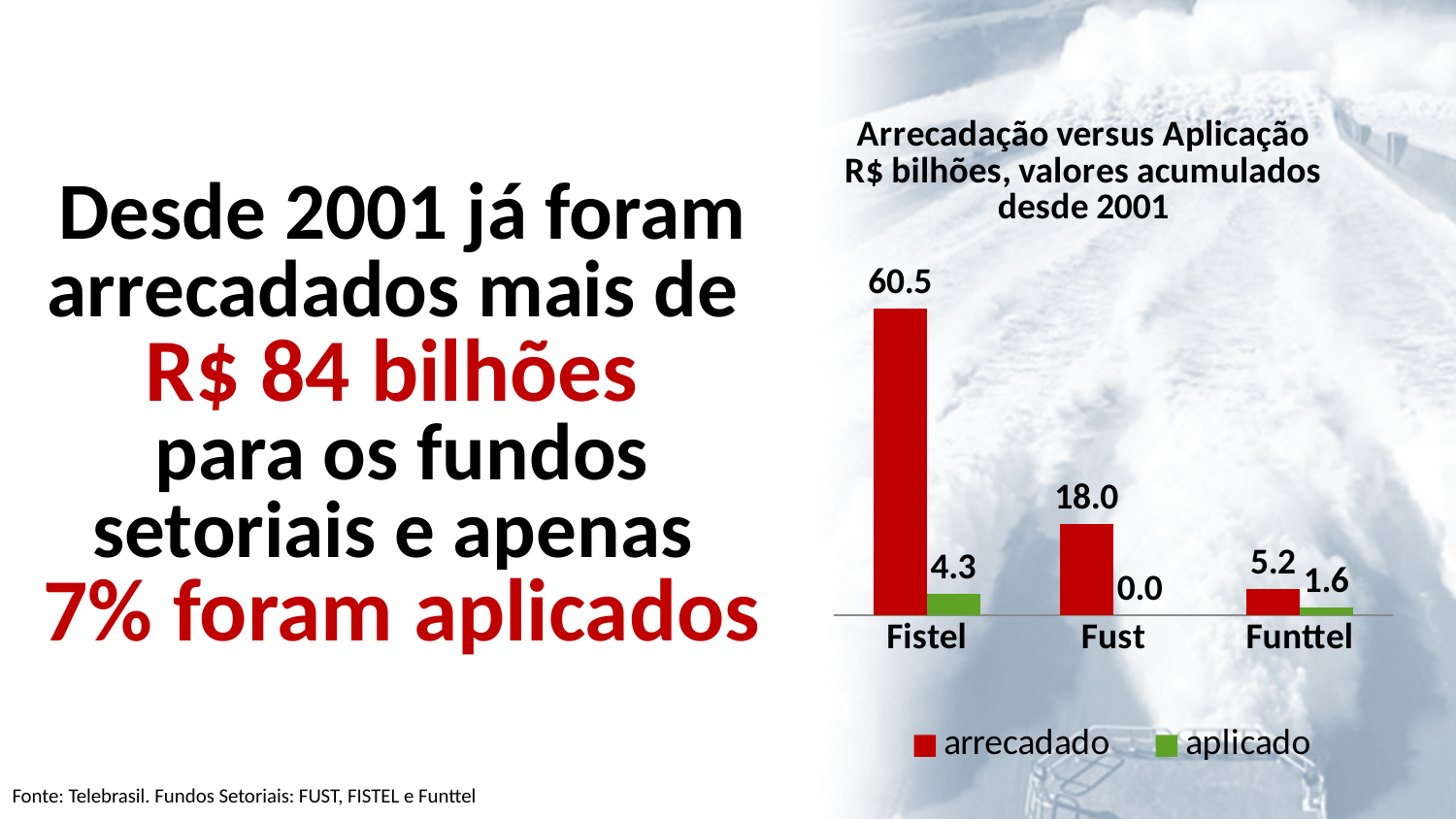
What is the 'arrecadado' value for Fistel? 60.5 What kind of chart is shown on the slide? Bar chart What is the 'aplicado' value for Fust? 0.0 Which category has the lowest 'aplicado' value? Fust What is the title of the chart? Arrecadação versus Aplicação R$ bilhões, valores acumulados desde 2001 How many categories are shown on the x axis of the chart? 3 What is the 'aplicado' value for Funttel? 1.6 Which is larger: the 'arrecadado' value for Fust or the 'arrecadado' value for Funttel? Fust Which category has the highest 'arrecadado' value? Fistel How many series does the legend list? 2 What is the difference between the 'arrecadado' and 'aplicado' values for Fistel? 56.2 What is the 'arrecadado' value for Fust? 18.0